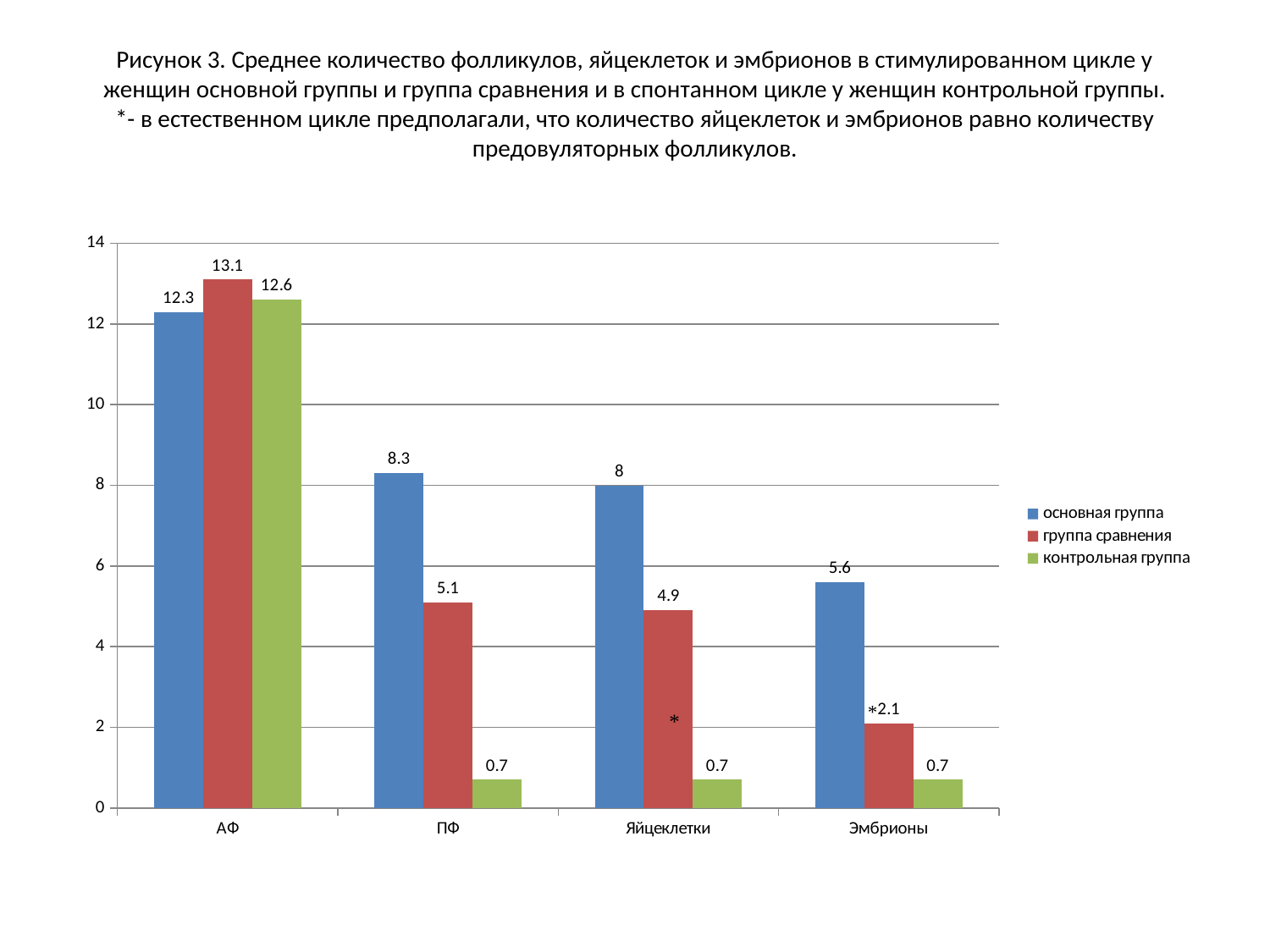
How many series does the legend list? 3 What is the value for основная группа in the ПФ category? 8.3 Which is larger in the Яйцеклетки category: основная группа or группа сравнения? основная группа Which series has the highest value in the АФ category? группа сравнения What kind of chart is shown on the slide? bar chart Which category has the lowest value for основная группа? Эмбрионы What is the value for группа сравнения in the АФ category? 13.1 What is the difference between основная группа and группа сравнения in the ПФ category? 3.2 What is the value for основная группа in the Эмбрионы category? 5.6 How many categories are shown on the x axis? 4 What is the value for контрольная группа in the Яйцеклетки category? 0.7 Does the value for основная группа rise or fall from ПФ to Эмбрионы? fall